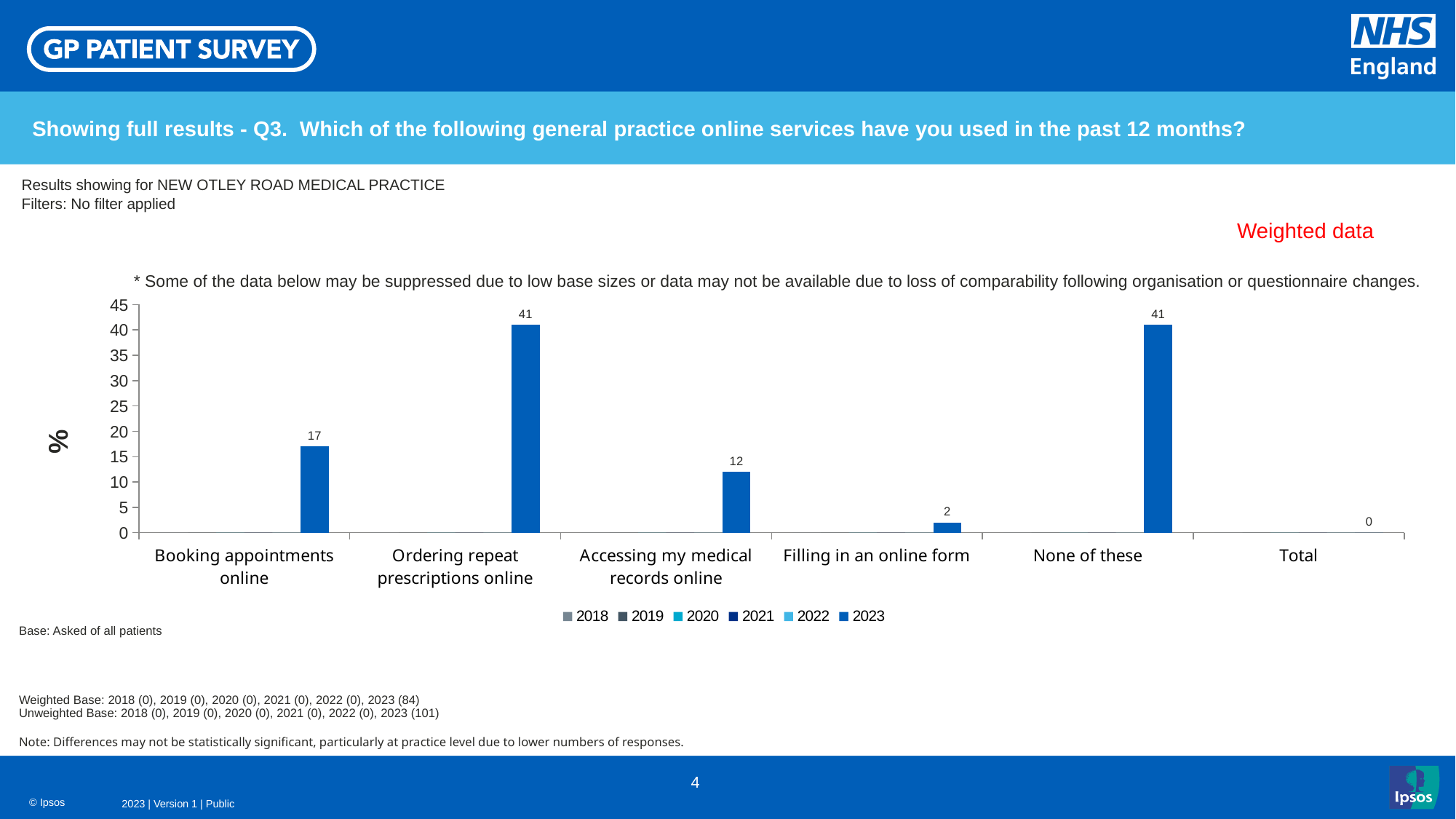
What is the label on the vertical axis? % What is the 2023 value for Accessing my medical records online? 12 What is the difference between the 2023 values for Ordering repeat prescriptions online and Booking appointments online? 24 What is the 2023 value for Booking appointments online? 17 How many series does the legend list? 6 What is the 2023 value for Ordering repeat prescriptions online? 41 What is the 2023 value for Filling in an online form? 2 What is the 2023 value for None of these? 41 Is the 2023 value for Ordering repeat prescriptions online greater or less than 40? greater Which is larger in 2023: Booking appointments online or Accessing my medical records online? Booking appointments online What kind of chart is shown on the slide? bar chart How many categories are shown on the x axis? 6